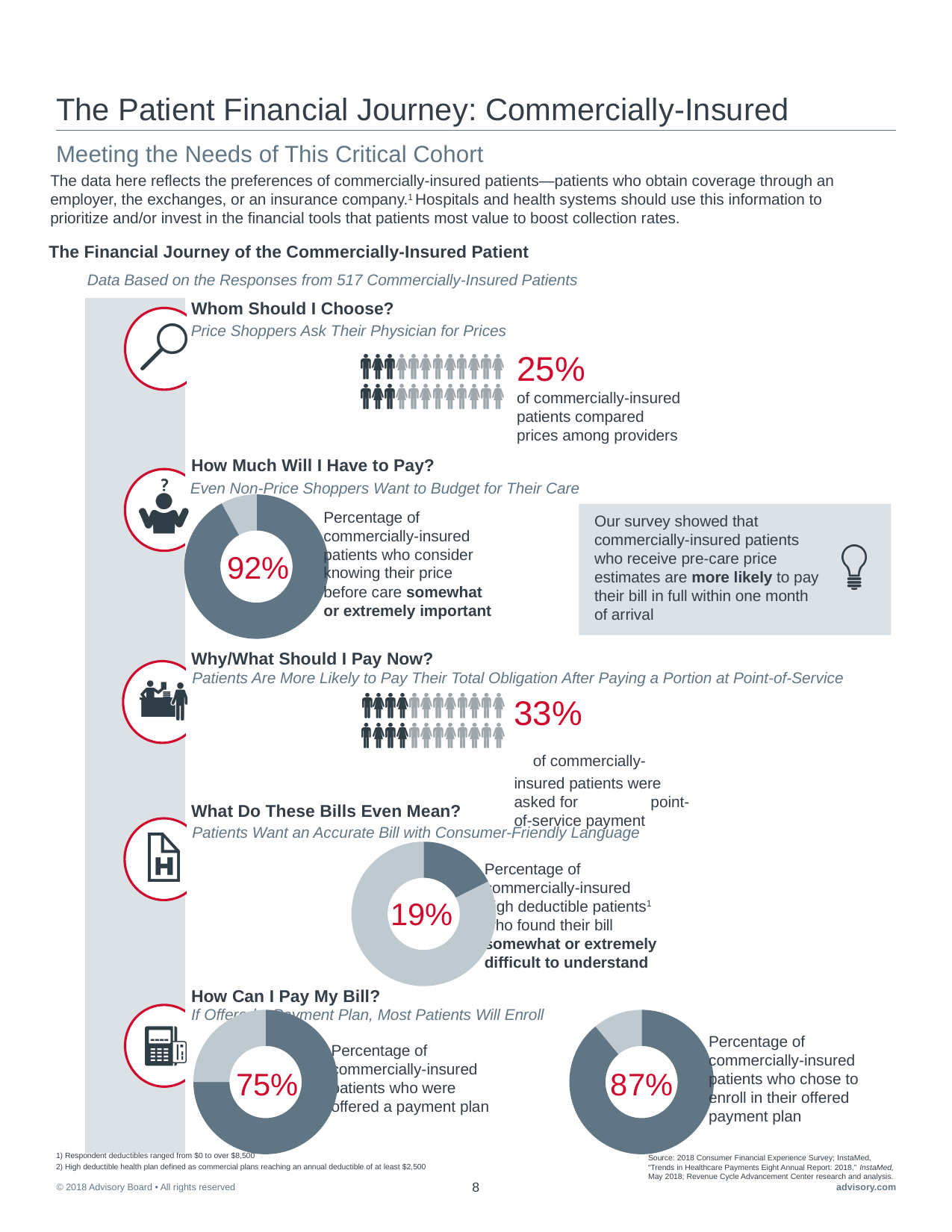
Of the four donut charts on the slide, which shows the highest percentage? The 'How Much Will I Have to Pay?' chart (92%) In the 'Whom Should I Choose?' section, what percentage of commercially-insured patients compared prices among providers according to the pictogram? 25% In the 'How Can I Pay My Bill?' section, what percentage does the left donut chart show for commercially-insured patients who were offered a payment plan? 75% In the 'Why/What Should I Pay Now?' section, what percentage of commercially-insured patients were asked for point-of-service payment according to the pictogram? 33% In the 'What Do These Bills Even Mean?' section, what percentage does the donut chart show for high deductible patients who found their bill somewhat or extremely difficult to understand? 19% In the 'How Can I Pay My Bill?' section, which donut chart shows the larger value: the one for patients offered a payment plan or the one for patients who enrolled in their offered payment plan? Patients who enrolled in their offered payment plan (87%) In the 'How Can I Pay My Bill?' section, what is the difference in percentage points between the right donut chart (87%) and the left donut chart (75%)? 12 percentage points Of the four donut charts on the slide, which shows the lowest percentage? The 'What Do These Bills Even Mean?' chart (19%) What kind of chart is used to show the 92% figure in the 'How Much Will I Have to Pay?' section? Donut (pie) chart In the 'How Can I Pay My Bill?' section, what percentage does the right donut chart show for patients who chose to enroll in their offered payment plan? 87% In the 'How Much Will I Have to Pay?' section, what percentage does the donut chart show for commercially-insured patients who consider knowing their price before care somewhat or extremely important? 92% How many donut charts are shown on the slide? 4